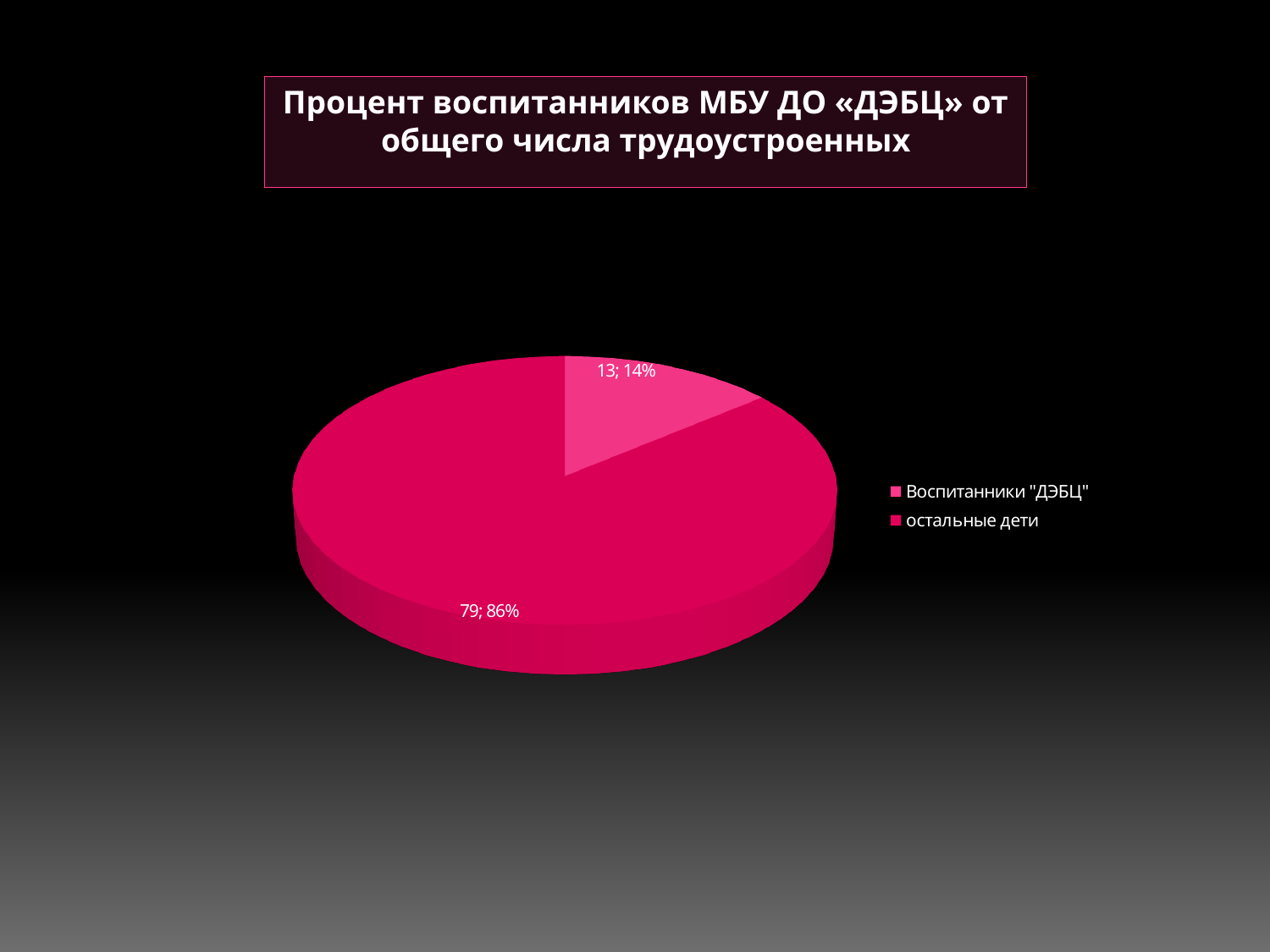
How many entries does the legend list? 2 What kind of chart is shown on the slide? Pie chart What share of the pie does the slice Воспитанники "ДЭБЦ" represent? 14% What share of the pie does the slice остальные дети represent? 86% Which is larger, the value for Воспитанники "ДЭБЦ" or the value for остальные дети? остальные дети What is the difference between the values for остальные дети and Воспитанники "ДЭБЦ"? 66 Which slice is the largest? остальные дети What value is shown for the slice Воспитанники "ДЭБЦ"? 13 How many slices does the pie chart have? 2 What value is shown for the slice остальные дети? 79 What is the title of the chart? Процент воспитанников МБУ ДО «ДЭБЦ» от общего числа трудоустроенных Which slice is the smallest? Воспитанники "ДЭБЦ"